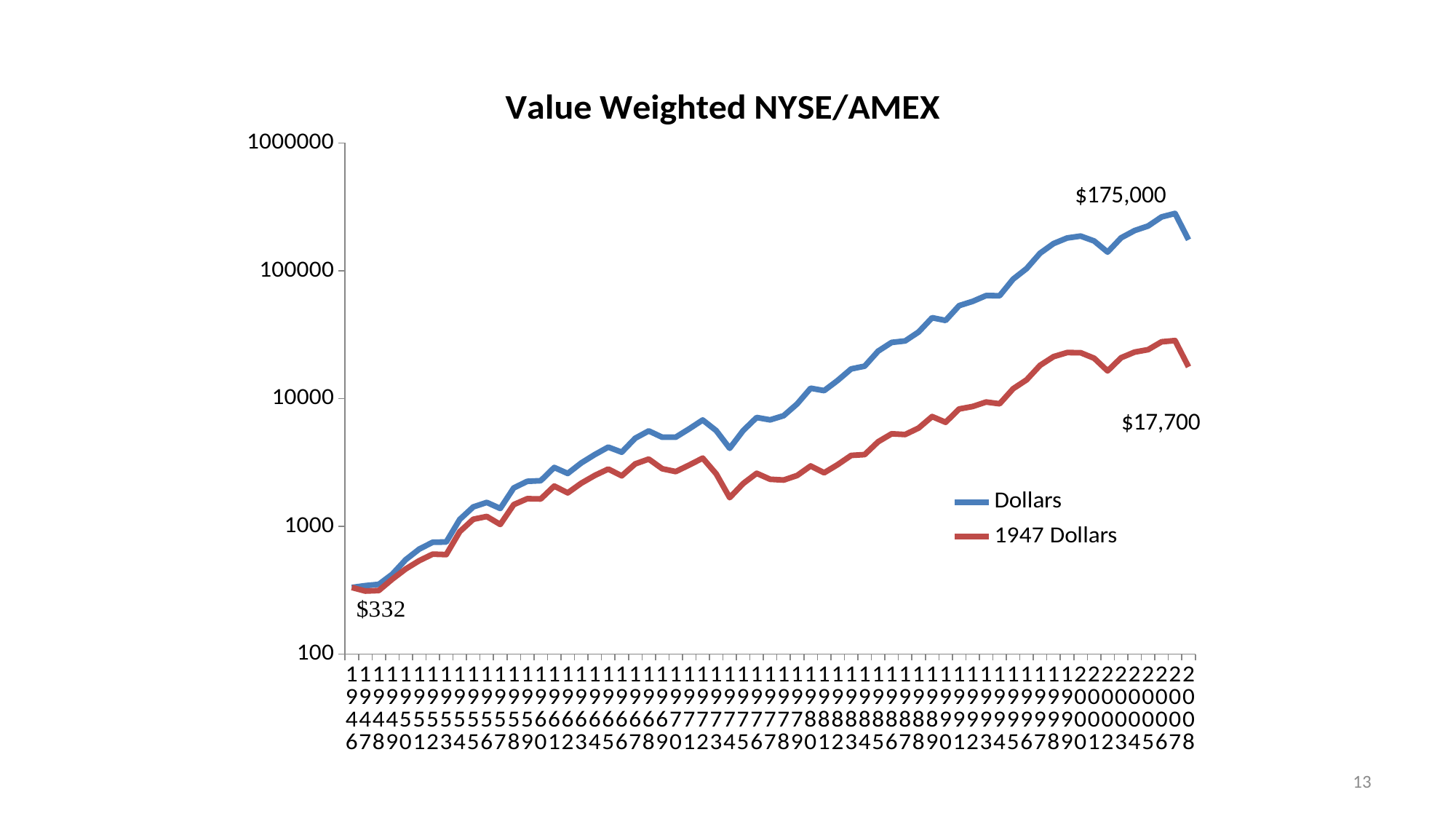
What value is annotated near the right end of the 1947 Dollars line? $17,700 What value is annotated near the right end of the Dollars line? $175,000 What kind of chart is shown on the slide? line chart Is the value for 1947 Dollars in 1946 greater or less than 1000? less How many series does the legend list? 2 In 2008, which series has the larger value, Dollars or 1947 Dollars? Dollars Is the value for 1947 Dollars in 2008 greater or less than 10000? greater What starting value is annotated at the left end of the lines? $332 Overall, do the values rise or fall from 1946 to 2008? rise What is the title of the chart? Value Weighted NYSE/AMEX Which series is drawn in red? 1947 Dollars Is the value for Dollars in 2008 greater or less than 100000? greater